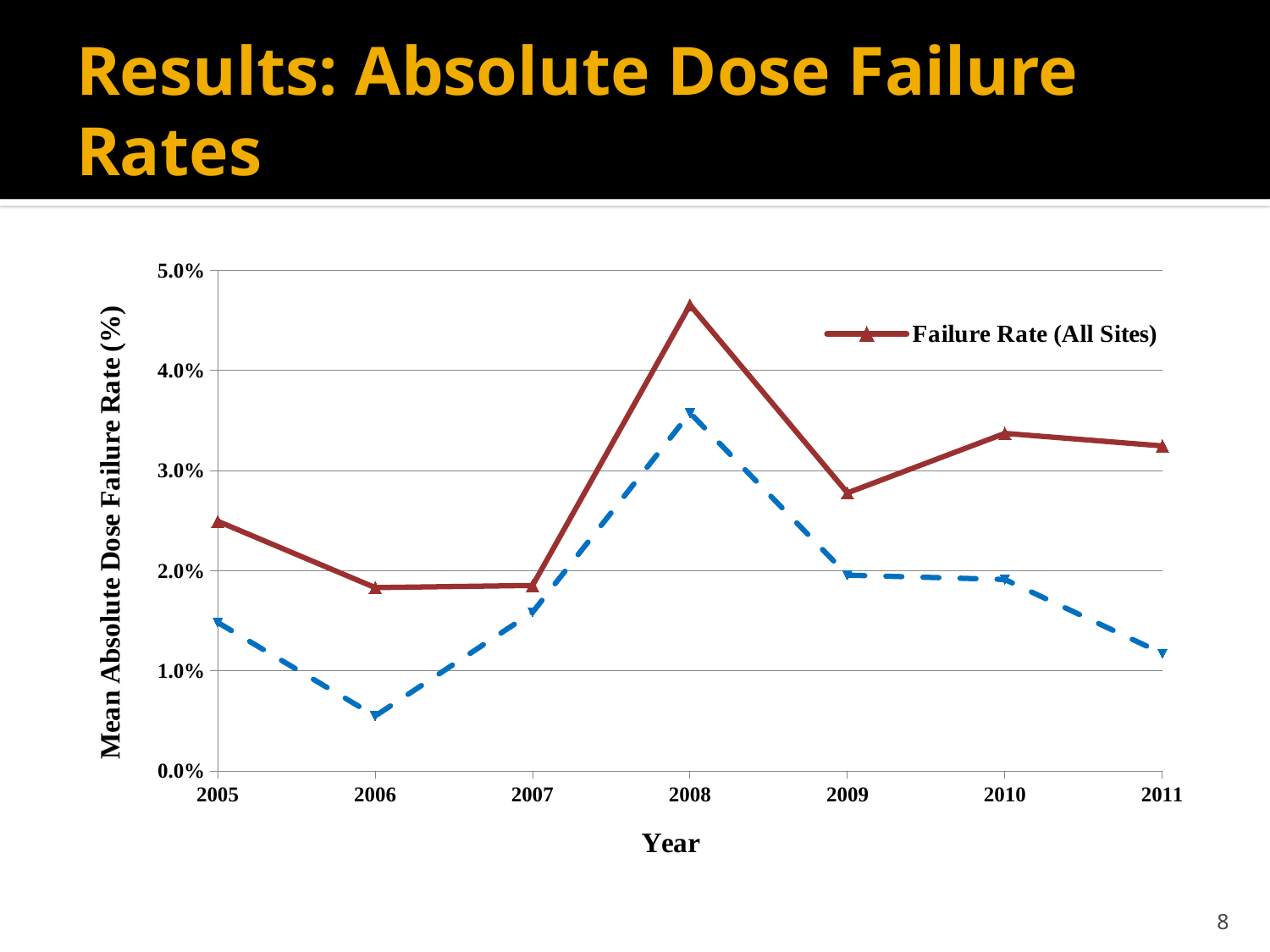
Is the Failure Rate (All Sites) value for 2009 greater or less than 3.0%? less Is the Failure Rate (All Sites) value for 2008 greater or less than 4.0%? greater What kind of chart is shown on the slide? Line chart Which year has the larger Failure Rate (All Sites) value, 2008 or 2009? 2008 Is the Failure Rate (All Sites) value for 2006 greater or less than 2.0%? less In which year does the blue dashed line reach its lowest value? 2006 In which year does the Failure Rate (All Sites) line reach its highest value? 2008 What is the label of the y axis? Mean Absolute Dose Failure Rate (%) Does the Failure Rate (All Sites) line rise or fall between 2007 and 2008? rise How many series does the legend list? 1 How many years are plotted along the x axis? 7